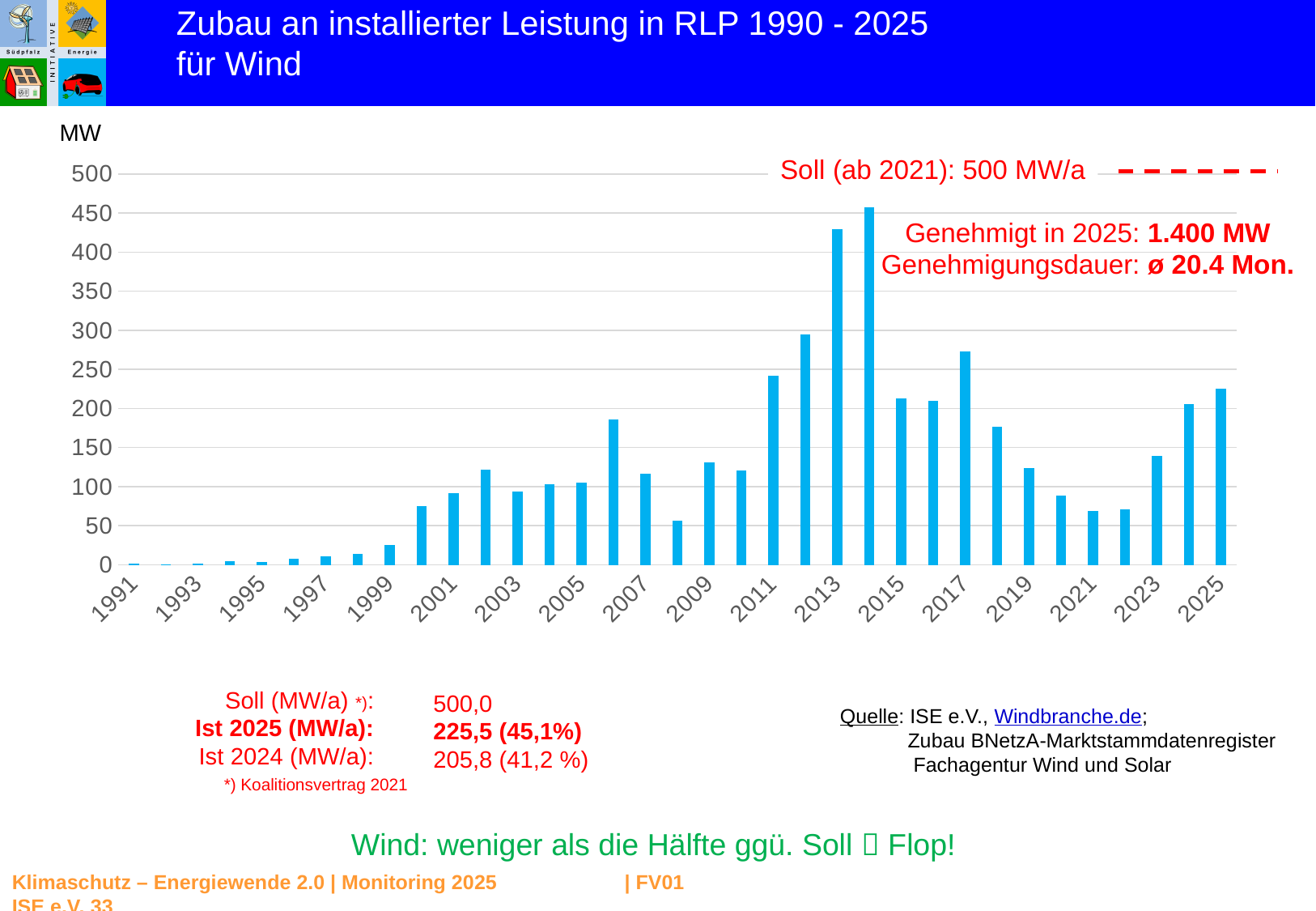
Do the bar values rise or fall from 2021 to 2025? rise What unit is shown on the y axis of the chart? MW Is the value for 2013 greater or less than 400? greater Which year has the larger bar, 2013 or 2014? 2014 Which year has the highest bar in the chart? 2014 What is the Soll value in MW/a shown for the dashed line from 2021 onwards? 500 MW/a What kind of chart is shown on the slide? bar chart Is the value for 2017 greater or less than 250? greater By how much does the Ist 2025 value (225,5) exceed the Ist 2024 value (205,8)? 19,7 Is the value for 2001 greater or less than 100? less What is the Ist 2024 value in MW/a given below the chart? 205,8 What is the Ist 2025 value in MW/a given below the chart? 225,5